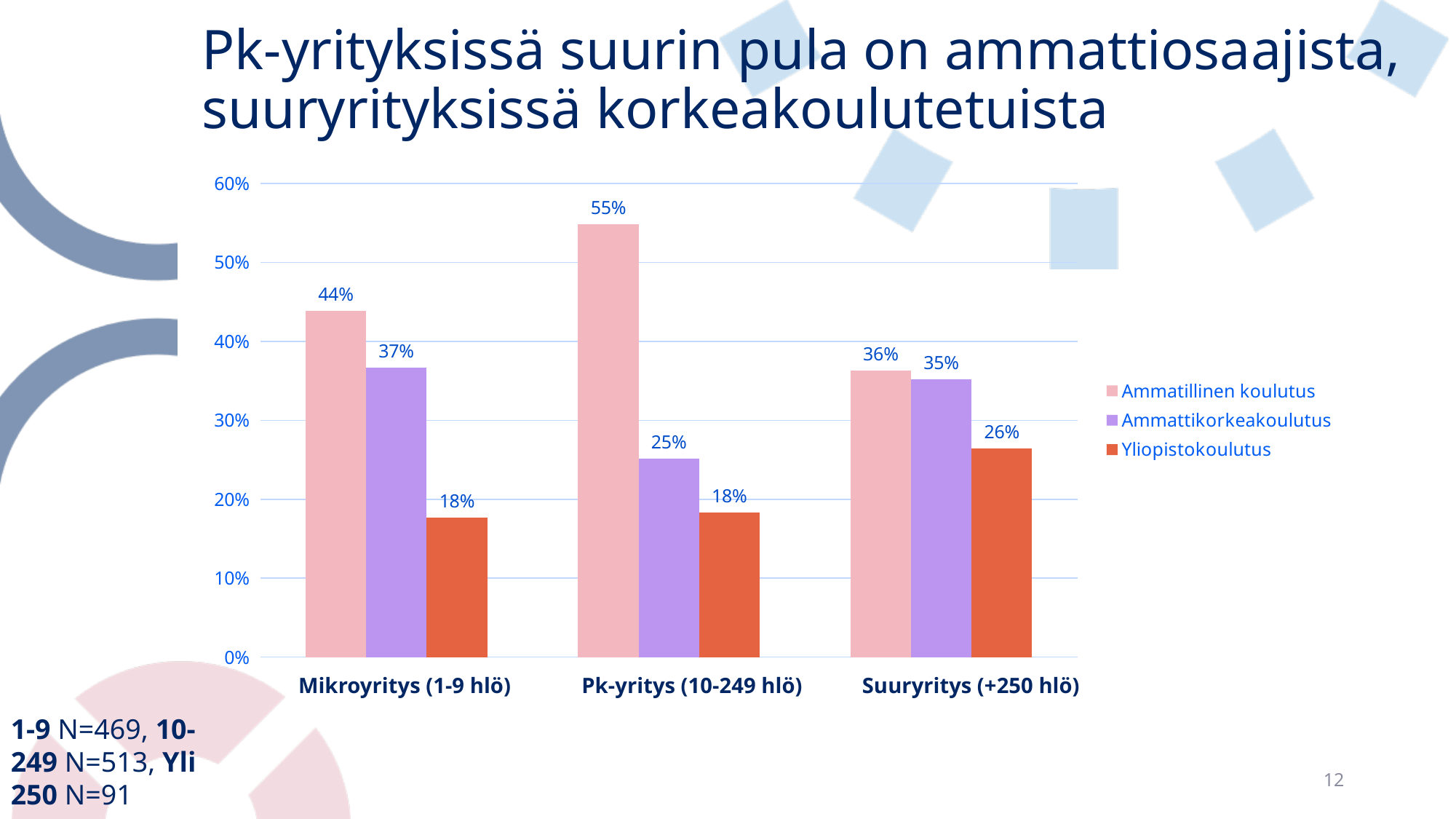
How many categories are shown on the x axis? 3 Which category has the lowest value for Ammattikorkeakoulutus? Pk-yritys (10-249 hlö) What is the value for Ammattikorkeakoulutus in the Mikroyritys (1-9 hlö) category? 37% What is the difference between Ammatillinen koulutus and Yliopistokoulutus in the Pk-yritys (10-249 hlö) category? 30% What kind of chart is shown on the slide? Bar chart Which is larger in the Mikroyritys (1-9 hlö) category: Ammatillinen koulutus or Yliopistokoulutus? Ammatillinen koulutus What is the value for Ammatillinen koulutus in the Pk-yritys (10-249 hlö) category? 55% How many series does the legend list? 3 Which category has the highest value for Ammatillinen koulutus? Pk-yritys (10-249 hlö) Does the value for Yliopistokoulutus rise or fall from Pk-yritys (10-249 hlö) to Suuryritys (+250 hlö)? Rise Is the value for Ammatillinen koulutus in the Pk-yritys (10-249 hlö) category greater or less than 50%? greater What is the value for Yliopistokoulutus in the Suuryritys (+250 hlö) category? 26%